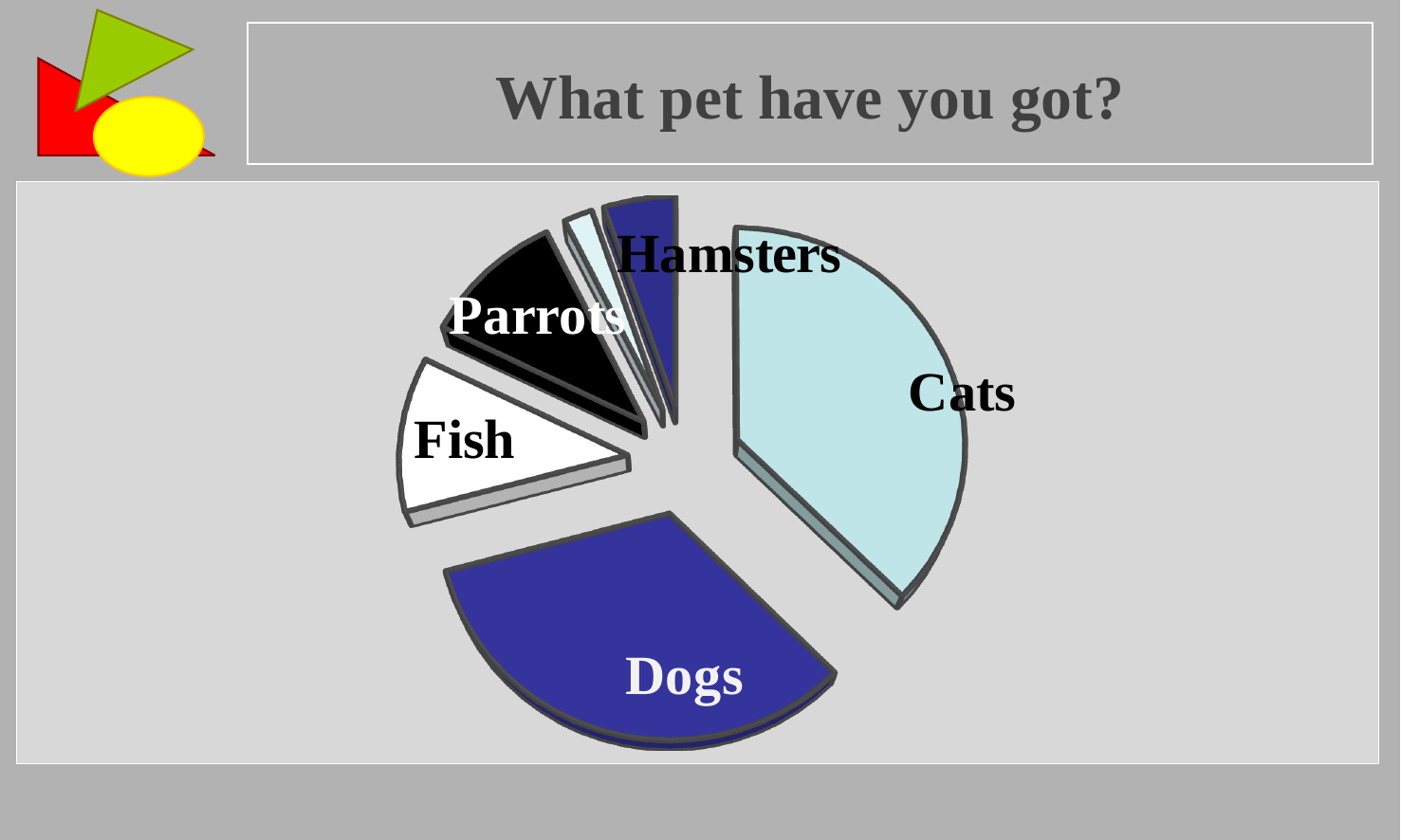
Which of the two slices is larger, Dogs or Parrots? Dogs Which of the two slices is larger, Dogs or Fish? Dogs What kind of chart is shown on the slide? pie chart Which of the two slices is larger, Fish or Hamsters? Fish What is the title of the slide containing the pie chart? What pet have you got? What colour is the Dogs slice of the pie? dark blue Which labelled slice of the pie is the smallest? Hamsters